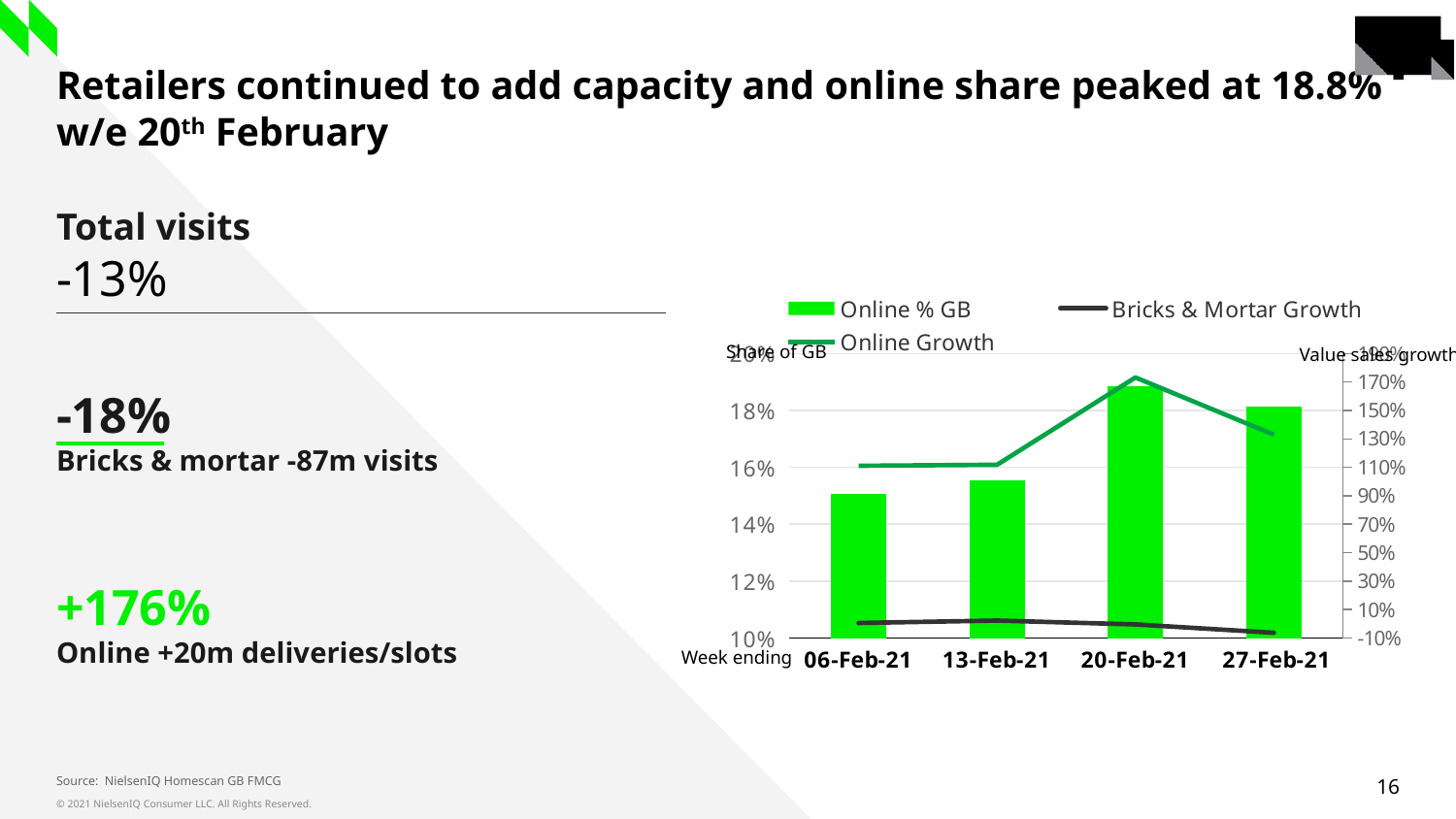
What is the label of the right-hand vertical axis? Value sales growth Is the Online Growth value for 20-Feb-21 greater or less than 150%? greater Is the Online % GB value for 20-Feb-21 greater or less than 18%? greater Which series is plotted as green bars? Online % GB Is the Online % GB bar for 20-Feb-21 or for 27-Feb-21 taller? 20-Feb-21 Is the Online % GB bar for 06-Feb-21 or for 20-Feb-21 taller? 20-Feb-21 What kind of chart is shown on the slide? A combination bar and line chart Which week ending has the highest Online % GB bar? 20-Feb-21 Is the Bricks & Mortar Growth value for 27-Feb-21 greater or less than 30%? less How many series does the chart legend list? 3 How many week-ending categories are shown on the x axis? 4